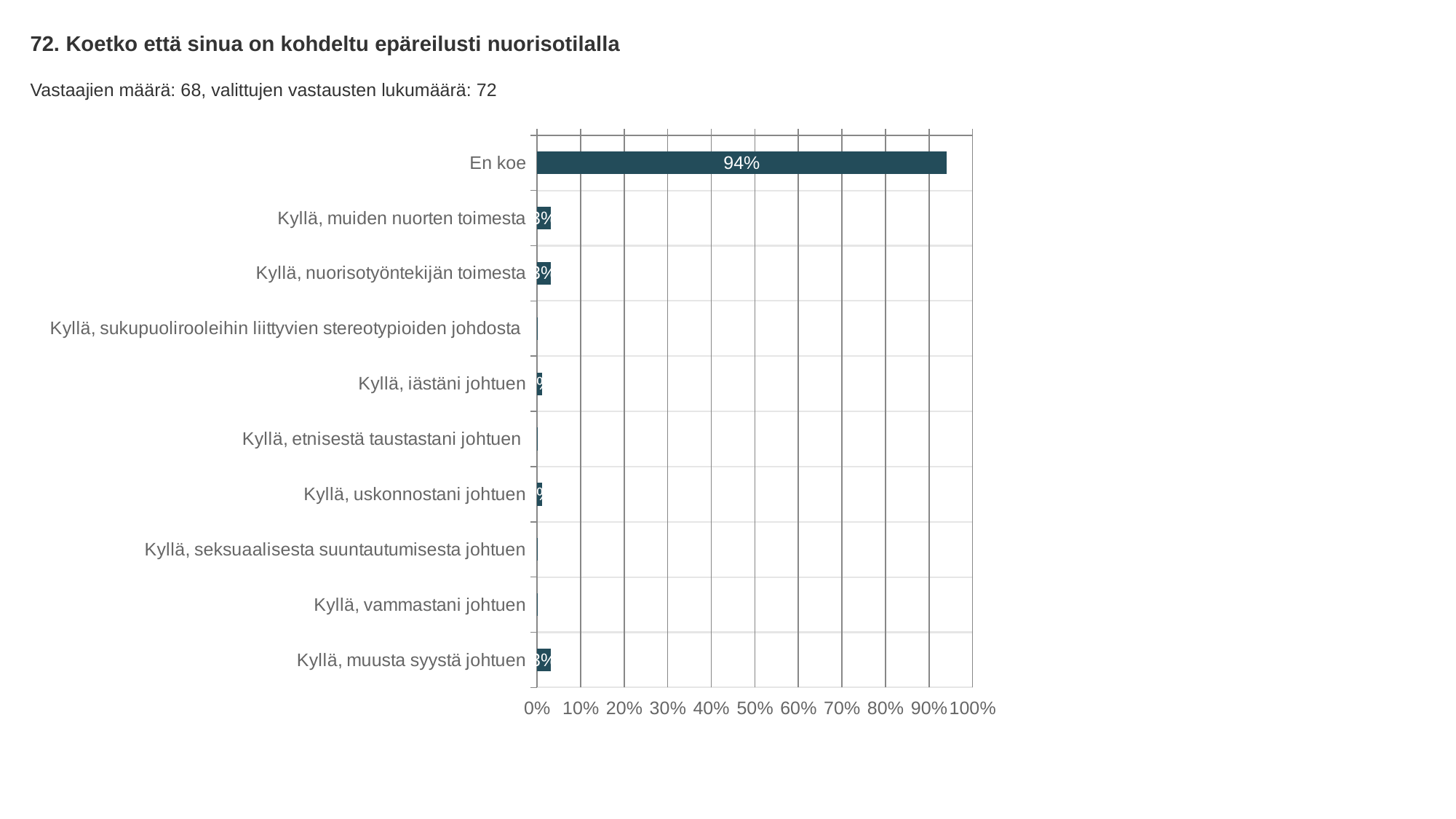
What is the value for "En koe"? 94% What kind of chart is shown on the slide? Bar chart Which category has the highest value? En koe Is the value for "Kyllä, muusta syystä johtuen" greater or less than 20%? less Is the value for "En koe" greater or less than 90%? greater How many categories are shown on the chart? 10 Which is larger, the value for "En koe" or the value for "Kyllä, nuorisotyöntekijän toimesta"? En koe What is the title of the chart? 72. Koetko että sinua on kohdeltu epäreilusti nuorisotilalla What is the highest value shown on the x axis? 100% Is the value for "Kyllä, iästäni johtuen" greater or less than 50%? less